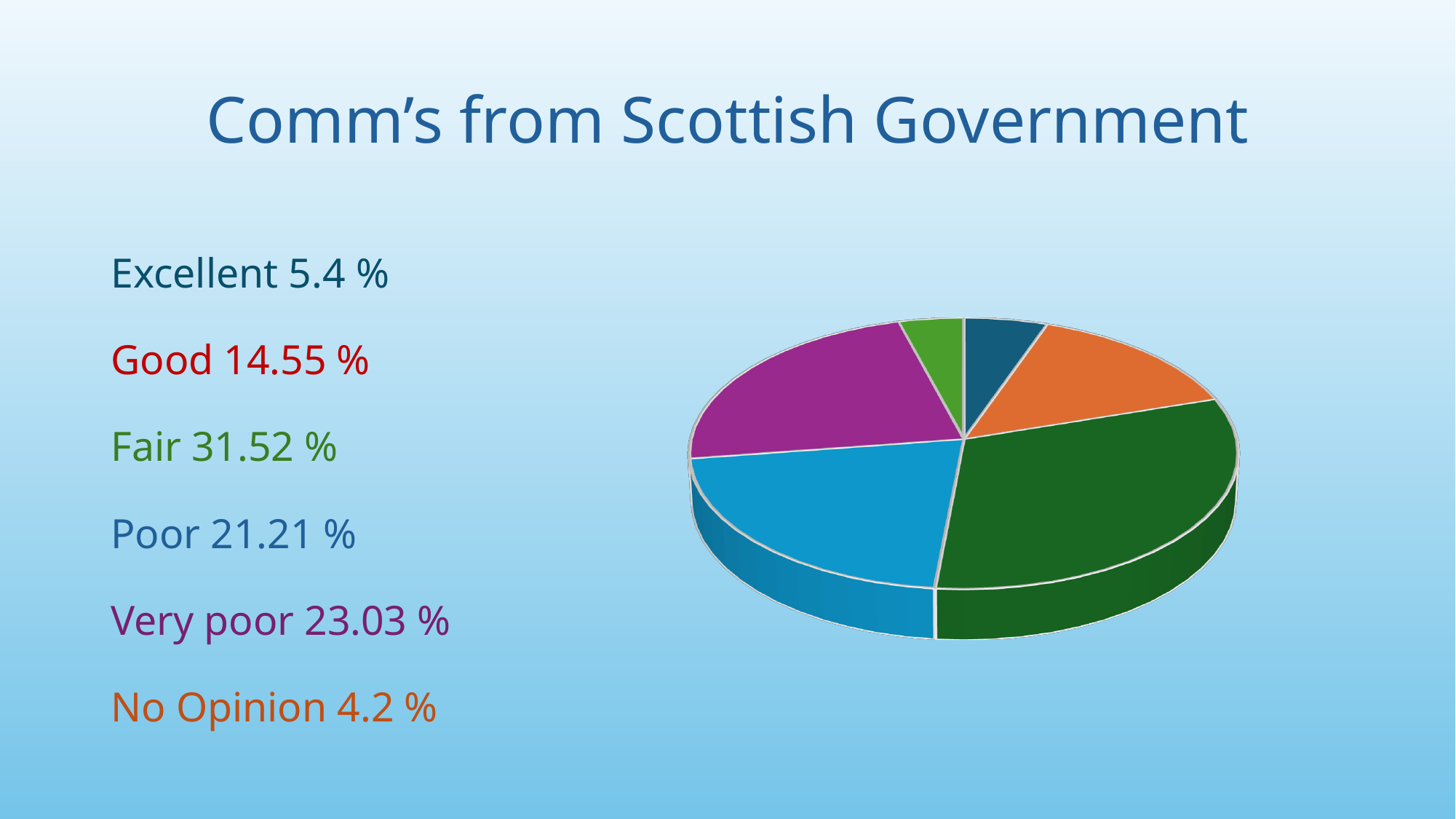
What is the combined percentage for Poor and Very poor? 44.24 % What kind of chart is shown on the slide? Pie chart What is the difference between the Very poor and Poor percentages? 1.82 % What percentage is shown for Fair? 31.52 % What percentage is shown for No Opinion? 4.2 % How many categories are shown in the pie chart? 6 What percentage is shown for Excellent? 5.4 % Which category has the largest share of the pie? Fair What percentage is shown for Very poor? 23.03 % What is the title of the slide? Comm’s from Scottish Government Which category has the smallest share of the pie? No Opinion Which is larger, Good or Poor? Poor